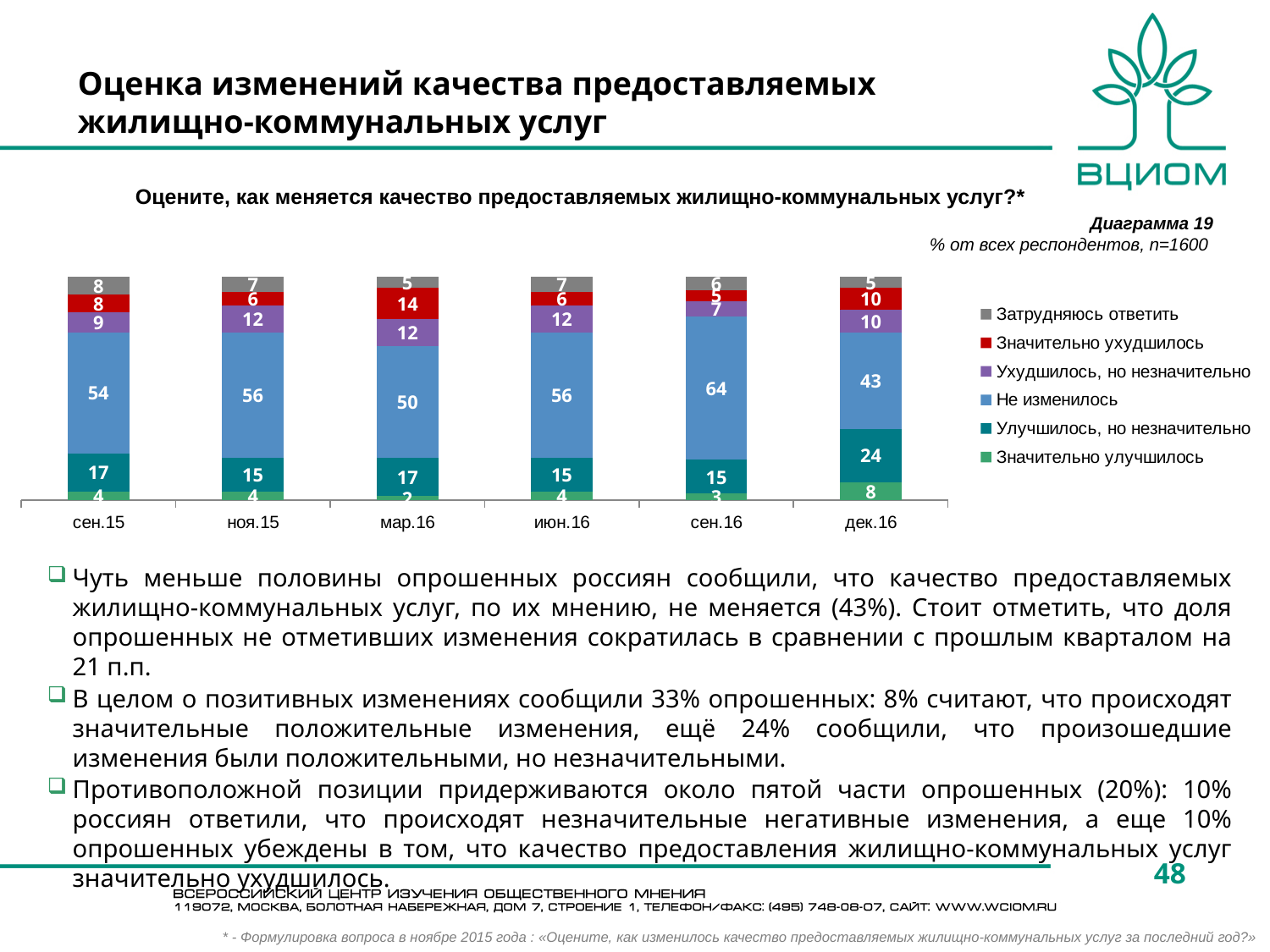
What is the value for "Не изменилось" in сен.16? 64 What is the value for "Не изменилось" in дек.16? 43 How many time periods are shown on the x axis? 6 What is the total of the stacked bar for дек.16? 100 Which is larger: the "Улучшилось, но незначительно" value for дек.16 or for сен.15? дек.16 What is the value for "Улучшилось, но незначительно" in дек.16? 24 What is the difference between the "Не изменилось" values for сен.16 and дек.16? 21 In which period is the "Не изменилось" value the highest? сен.16 What kind of chart is shown on the slide? Stacked bar chart How many series does the legend list? 6 What is the value for "Значительно ухудшилось" in мар.16? 14 In which period is the "Не изменилось" value the lowest? дек.16